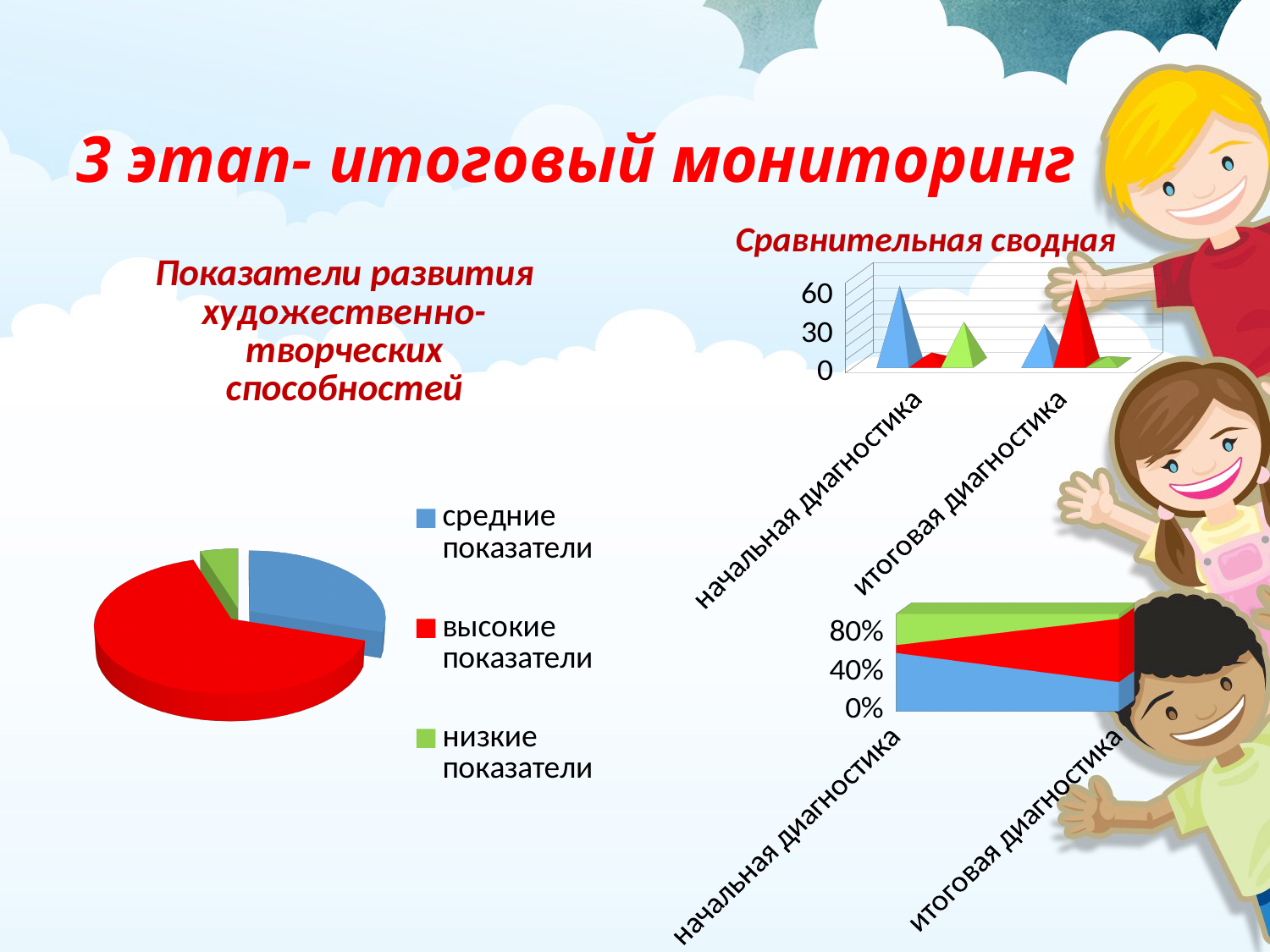
In the pie chart on the left, which category has the largest slice? высокие показатели In the 'Сравнительная сводная' chart, is the value of the red series for 'итоговая диагностика' greater or less than 30? greater In the pie chart on the left, which colour represents 'средние показатели'? blue In the 'Сравнительная сводная' chart, does the red series rise or fall from 'начальная диагностика' to 'итоговая диагностика'? rise In the 'Сравнительная сводная' chart, which series is highest for 'итоговая диагностика'? red In the pie chart on the left, which category has the smallest slice? низкие показатели In the 'Сравнительная сводная' chart, how many categories are shown on the x axis? 2 In the 'Сравнительная сводная' chart, is the value of the blue series for 'начальная диагностика' greater or less than 30? greater How many entries does the legend of the pie chart on the left list? 3 In the bottom-right chart, does the blue area rise or fall from 'начальная диагностика' to 'итоговая диагностика'? fall What kind of chart is the chart on the left of the slide? pie chart In the 'Сравнительная сводная' chart, is the value of the red series for 'начальная диагностика' greater or less than 30? less